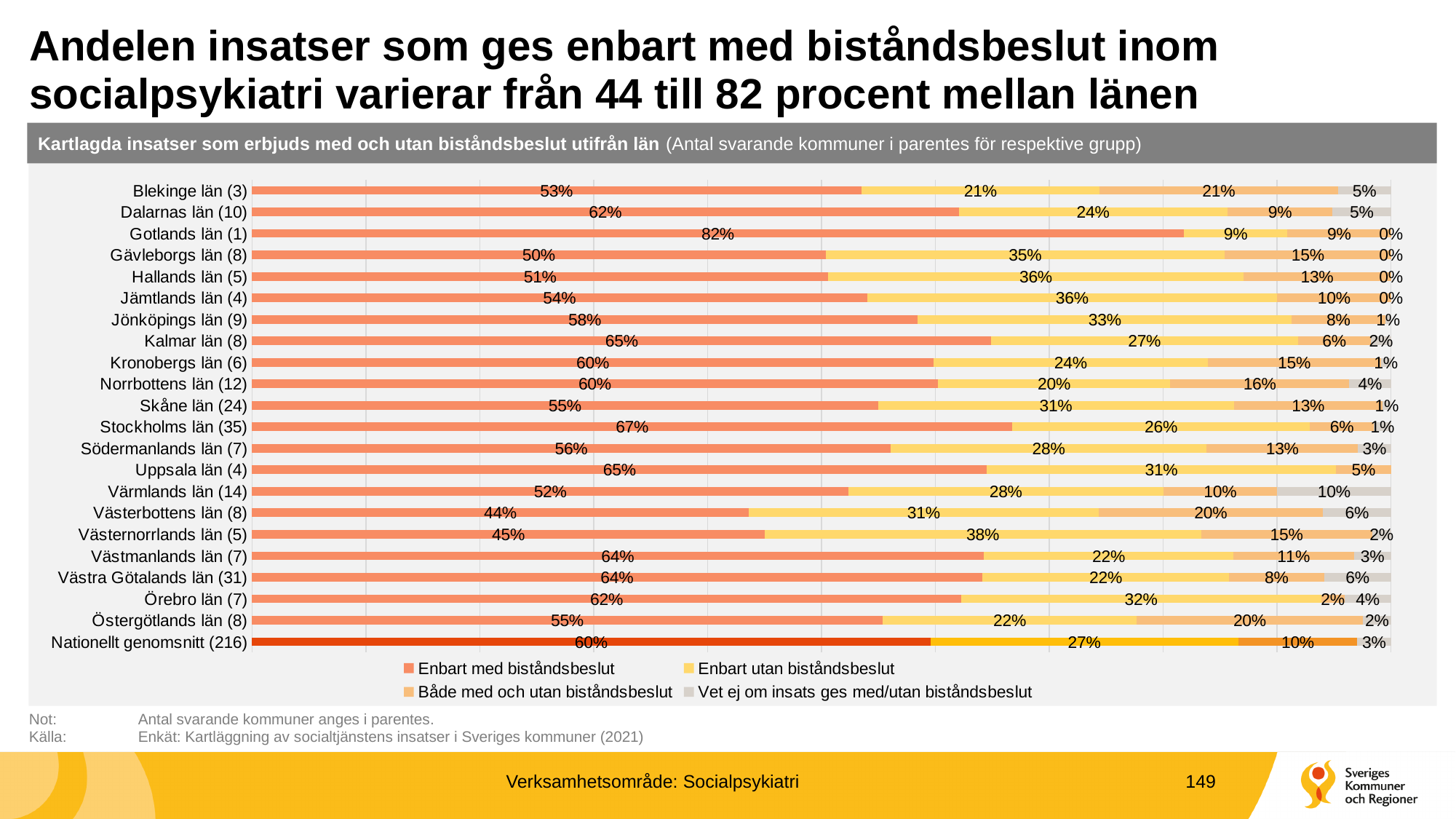
What is the difference in 'Enbart med biståndsbeslut' between Gotlands län (1) and Västerbottens län (8)? 38 percentage points What is the value for 'Enbart utan biståndsbeslut' for Nationellt genomsnitt (216)? 27% Which has a larger value for 'Enbart med biståndsbeslut', Dalarnas län (10) or Jönköpings län (9)? Dalarnas län (10) How many series does the legend list? 4 What is the value for 'Vet ej om insats ges med/utan biståndsbeslut' for Värmlands län (14)? 10% Which län has the lowest value for 'Enbart med biståndsbeslut'? Västerbottens län (8) What kind of chart is shown on the slide? Stacked bar chart Which län has the highest value for 'Enbart med biståndsbeslut'? Gotlands län (1) What is the total of the stacked bar for Blekinge län (3)? 100% What is the value for 'Både med och utan biståndsbeslut' for Västerbottens län (8)? 20% How many bars (categories) are shown in the chart? 22 What is the value for 'Enbart med biståndsbeslut' for Gotlands län (1)? 82%